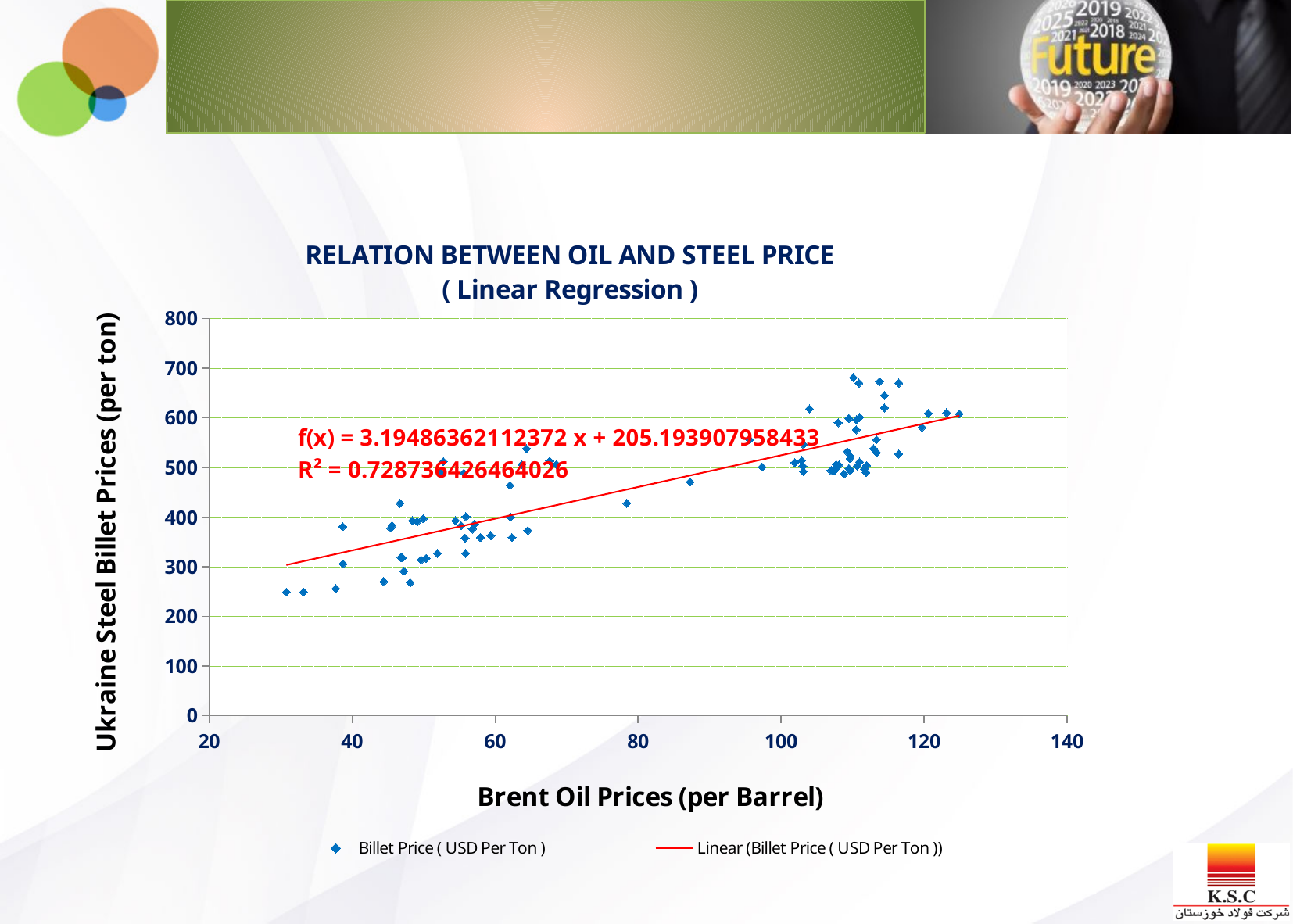
What is the slope (coefficient of x) in the regression equation printed on the chart? 3.19486362112372 Is the lowest billet price point on the chart greater or less than 300? less Do the billet prices generally rise or fall as Brent oil prices increase along the x axis? Rise What is the title of the chart? RELATION BETWEEN OIL AND STEEL PRICE ( Linear Regression ) What is the intercept in the regression equation printed on the chart? 205.193907958433 What is the label of the x axis? Brent Oil Prices (per Barrel) What is the maximum value shown on the x axis? 140 What kind of chart is shown on the slide? Scatter chart What R² value is printed on the chart? 0.728736426464026 How many entries does the chart legend list? 2 Is the highest billet price point on the chart greater or less than 600? greater What is the maximum value shown on the y axis? 800